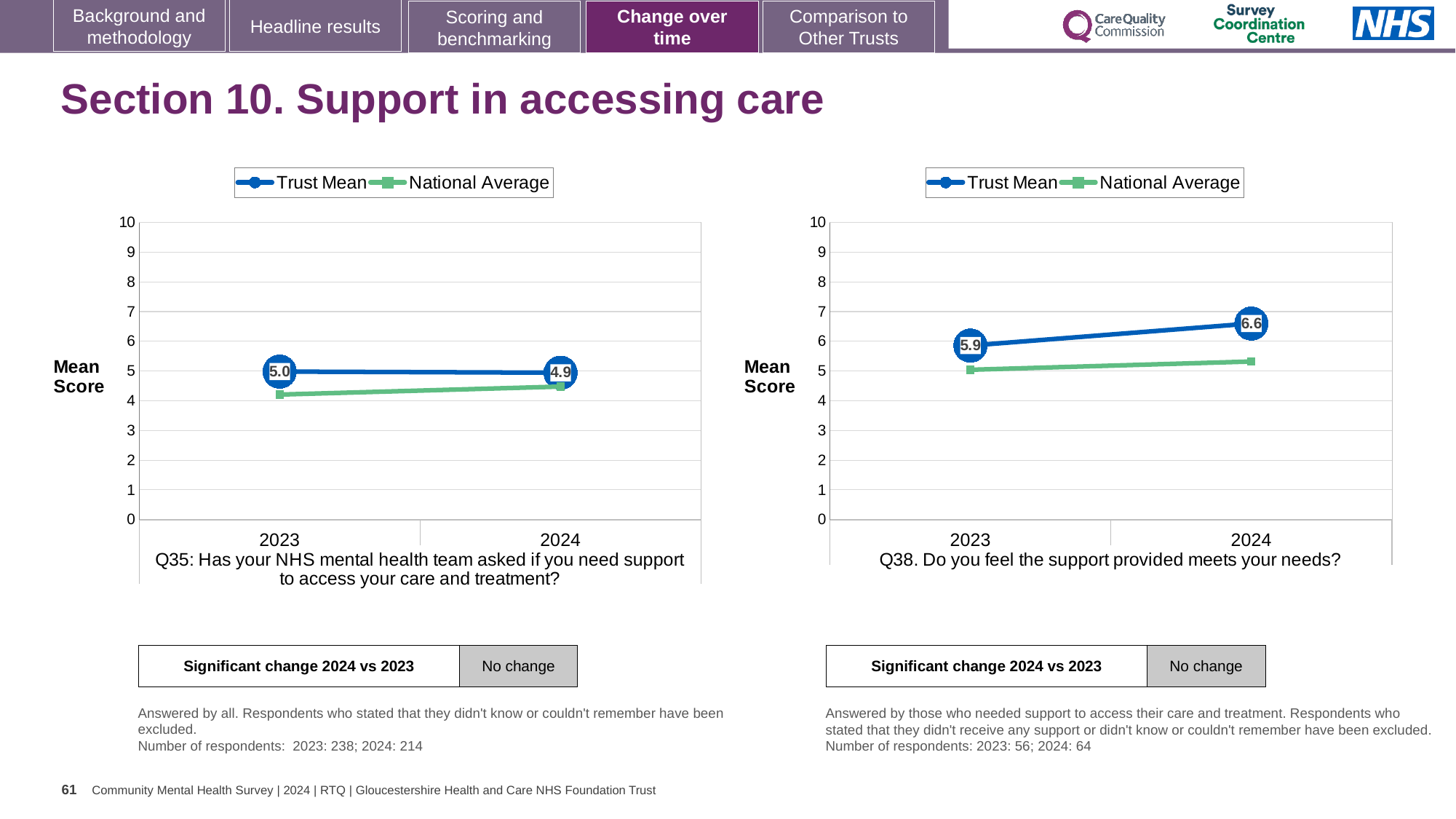
In the Q38 chart on the right, which series has the higher value in 2024, Trust Mean or National Average? Trust Mean What kind of chart is the Q35 chart on the left? line chart In the Q35 chart on the left, is the National Average value for 2023 greater or less than 5? less How many years are shown on the x axis of the Q35 chart on the left? 2 In the Q38 chart on the right, what is the Trust Mean score for 2024? 6.6 In the Q35 chart on the left, what is the Trust Mean score for 2023? 5.0 In the Q35 chart on the left, does the National Average rise or fall from 2023 to 2024? rise How many series does the legend of the Q38 chart on the right list? 2 In the Q35 chart on the left, what is the Trust Mean score for 2024? 4.9 In the Q38 chart on the right, by how much did the Trust Mean change from 2023 to 2024? 0.7 In the Q38 chart on the right, does the Trust Mean rise or fall from 2023 to 2024? rise In the Q38 chart on the right, what is the Trust Mean score for 2023? 5.9